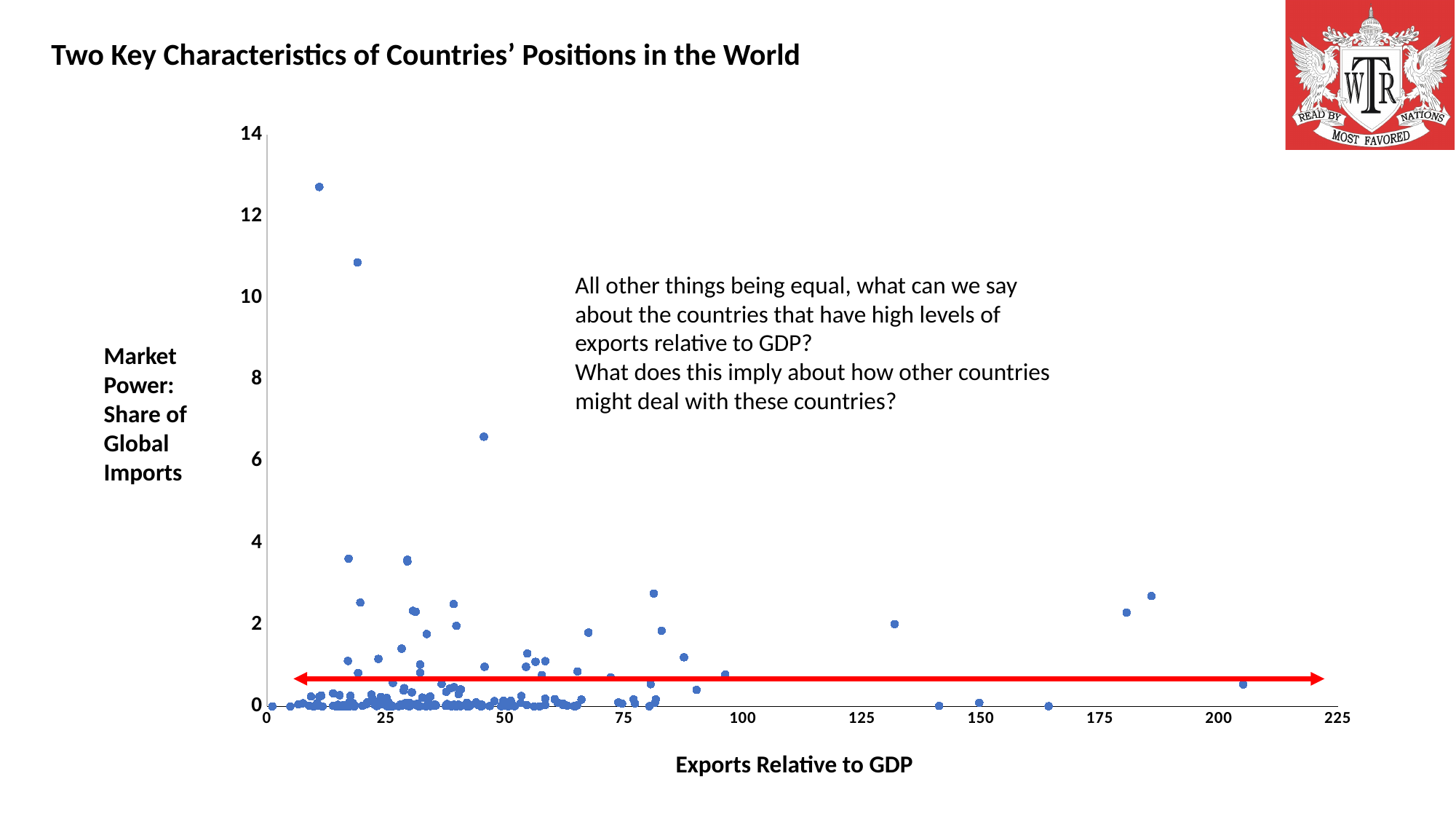
Is the exports-relative-to-GDP value for the point at roughly 6.5 on the vertical axis greater or less than 50? less Is the exports-relative-to-GDP value for the rightmost point on the chart greater or less than 200? greater Is the share of global imports for the second-highest point on the chart greater or less than 10? greater What is the label of the horizontal axis of the chart? Exports Relative to GDP What kind of chart is shown on the slide? scatter plot What is the label of the vertical axis of the chart? Market Power: Share of Global Imports